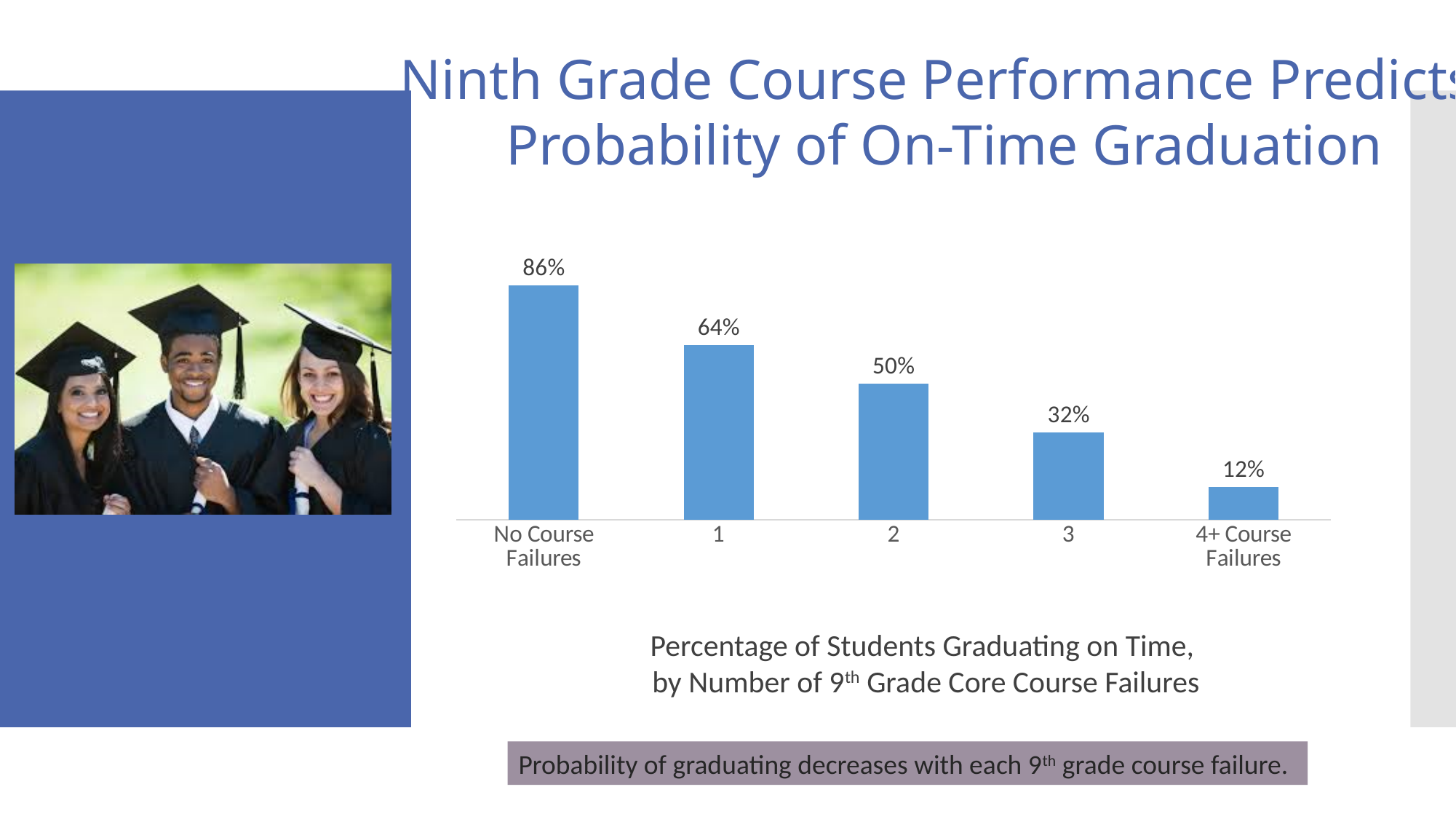
Do the values rise or fall as the number of course failures increases along the x axis? Fall Which is larger, the value for 1 course failure or the value for 3 course failures? 1 course failure What kind of chart is shown on the slide? Bar chart What is the on-time graduation percentage for students with 2 course failures? 50% What is the difference between the values for 3 course failures and 4+ course failures? 20% How many categories are shown on the x axis of the chart? 5 Which category has the highest on-time graduation percentage? No Course Failures Which category has the lowest on-time graduation percentage? 4+ Course Failures What is the difference in on-time graduation percentage between students with no course failures and those with 1 course failure? 22% What is the value shown for 4+ course failures? 12% What is the caption below the chart? Percentage of Students Graduating on Time, by Number of 9th Grade Core Course Failures What percentage of students with no course failures graduate on time? 86%